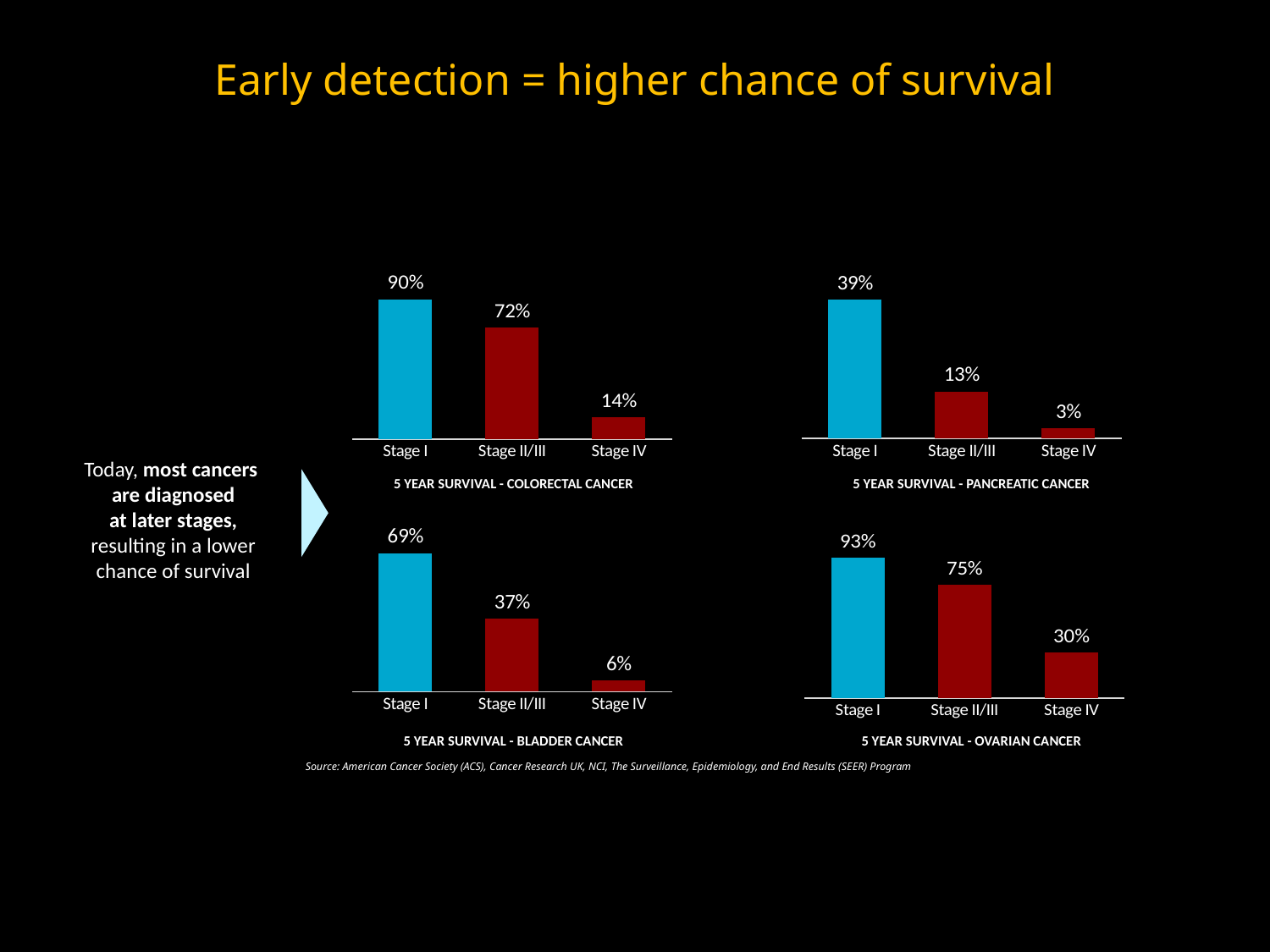
In the '5 YEAR SURVIVAL - COLORECTAL CANCER' chart, what is the value for Stage I? 90% In the '5 YEAR SURVIVAL - COLORECTAL CANCER' chart, do the values rise or fall from Stage I to Stage IV? Fall In the '5 YEAR SURVIVAL - OVARIAN CANCER' chart, which stage has the highest value? Stage I What type of chart is the '5 YEAR SURVIVAL - PANCREATIC CANCER' chart? Bar chart In the '5 YEAR SURVIVAL - COLORECTAL CANCER' chart, what is the difference between the Stage I and Stage IV values? 76% In the '5 YEAR SURVIVAL - PANCREATIC CANCER' chart, what is the value for Stage IV? 3% How many stage categories are shown in the '5 YEAR SURVIVAL - BLADDER CANCER' chart? 3 In the '5 YEAR SURVIVAL - OVARIAN CANCER' chart, what is the value for Stage IV? 30% In the '5 YEAR SURVIVAL - BLADDER CANCER' chart, which stage has the lowest value? Stage IV Which is larger: the Stage II/III value in the '5 YEAR SURVIVAL - OVARIAN CANCER' chart or the Stage II/III value in the '5 YEAR SURVIVAL - COLORECTAL CANCER' chart? Ovarian cancer (75%) In the '5 YEAR SURVIVAL - PANCREATIC CANCER' chart, what is the difference between the Stage I and Stage II/III values? 26% In the '5 YEAR SURVIVAL - BLADDER CANCER' chart, what is the value for Stage II/III? 37%